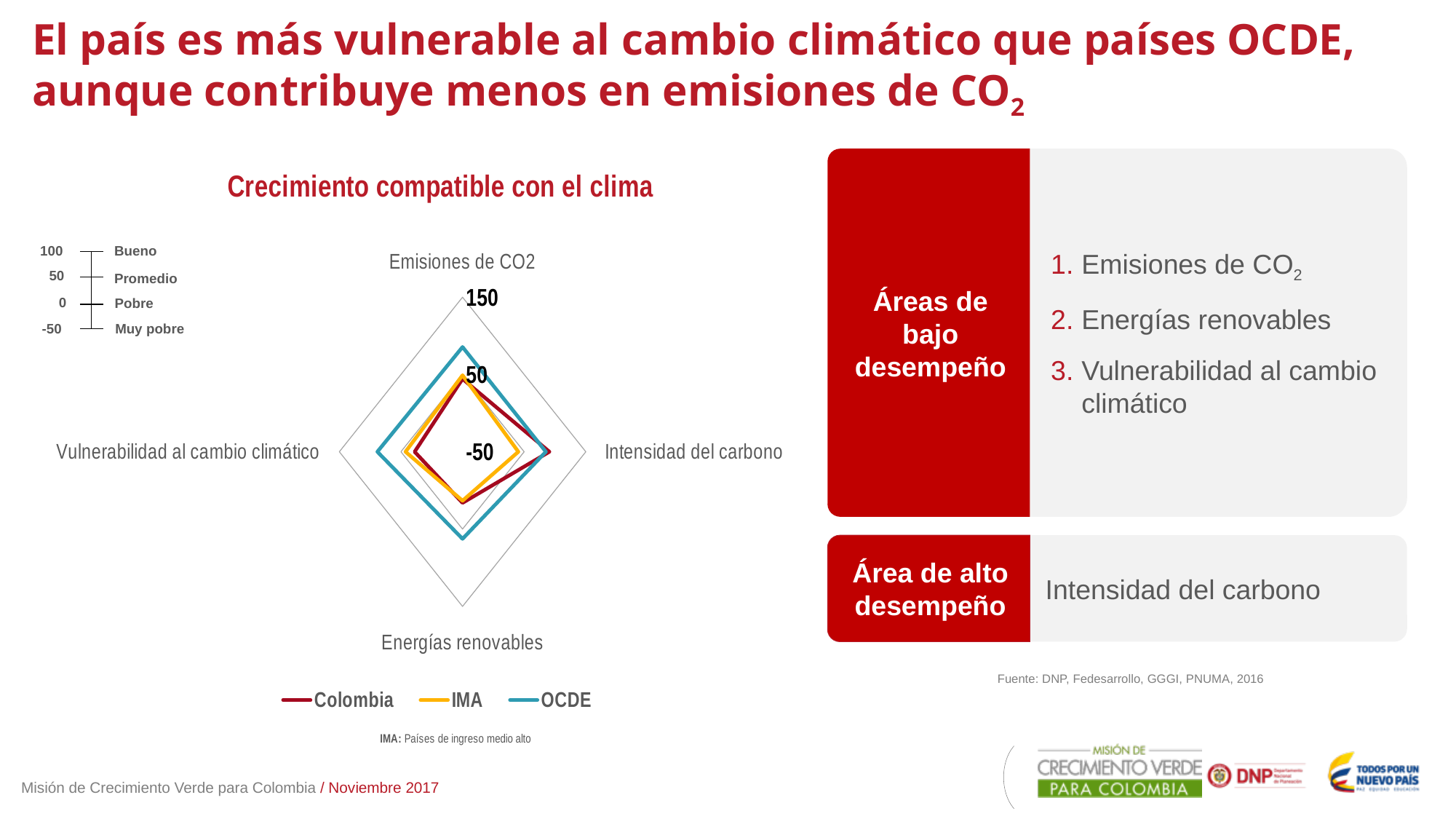
How many categories (axes) does the radar chart have? 4 What is the title of the chart? Crecimiento compatible con el clima Is the Colombia value for Energías renovables greater or less than 50? less Which series has the highest value for Emisiones de CO2? OCDE Is the OCDE value for Emisiones de CO2 greater or less than 50? greater What kind of chart is shown on the slide? Radar chart Is the Colombia value for Intensidad del carbono greater or less than 50? greater How many series does the chart legend list? 3 For Intensidad del carbono, which is larger: the value for Colombia or for IMA? Colombia On which category does Colombia have its highest value? Intensidad del carbono Which series are listed in the chart legend? Colombia, IMA, OCDE For Vulnerabilidad al cambio climático, which is larger: the value for Colombia or for OCDE? OCDE